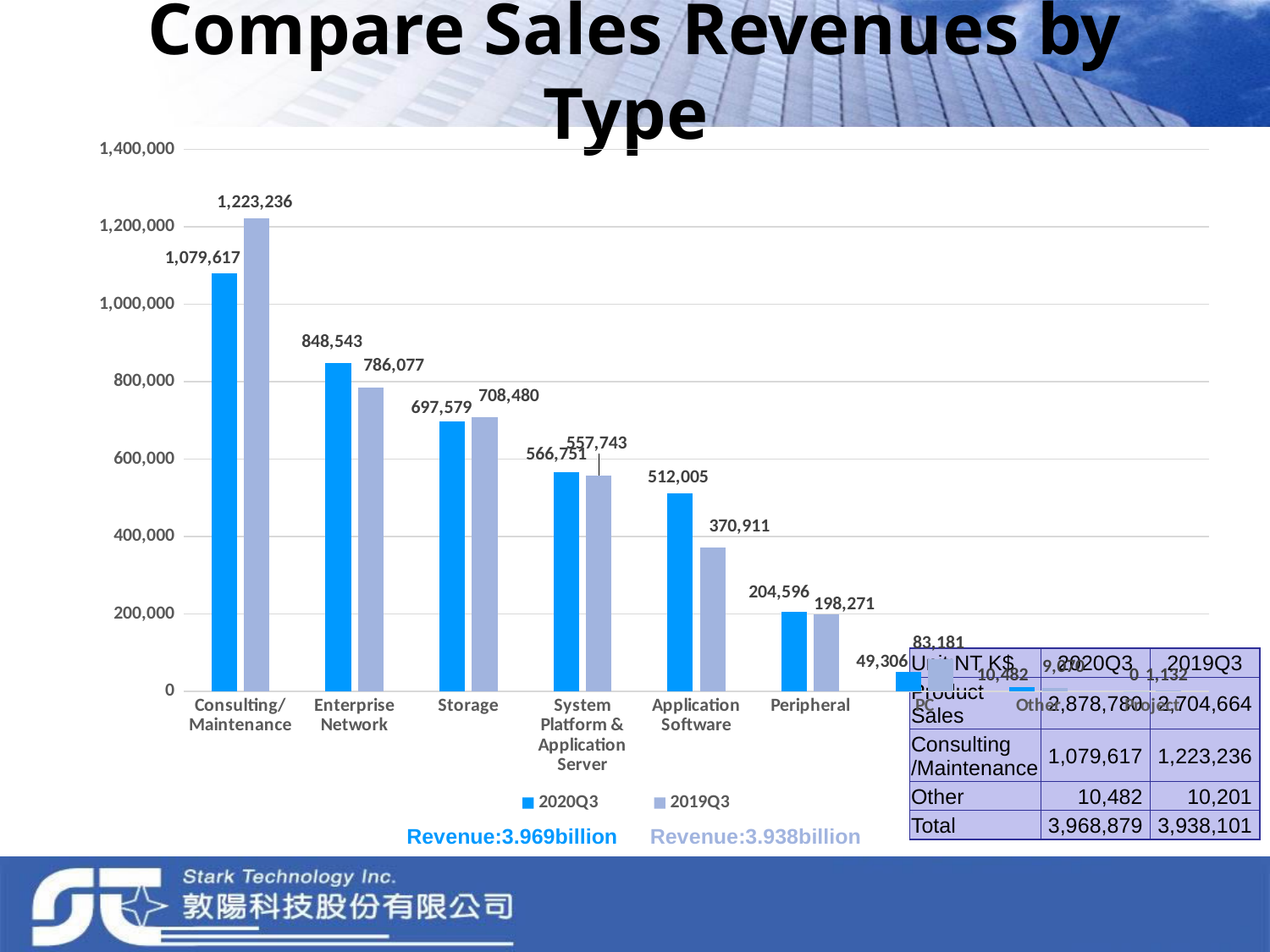
What is the 2020Q3 value for Consulting/Maintenance? 1,079,617 How much larger is the 2019Q3 value than the 2020Q3 value for Consulting/Maintenance? 143,619 What kind of chart is shown on the slide? bar chart What is the difference between the 2020Q3 and 2019Q3 values for Application Software? 141,094 What is the 2020Q3 value for Application Software? 512,005 How many series does the legend list? 2 What is the 2019Q3 value for Enterprise Network? 786,077 Is the 2020Q3 value for Peripheral greater or less than 200,000? greater What is the 2019Q3 value for Peripheral? 198,271 For System Platform & Application Server, which series has the larger value, 2020Q3 or 2019Q3? 2020Q3 For Storage, which series has the larger value, 2020Q3 or 2019Q3? 2019Q3 Which category has the highest 2019Q3 value? Consulting/Maintenance